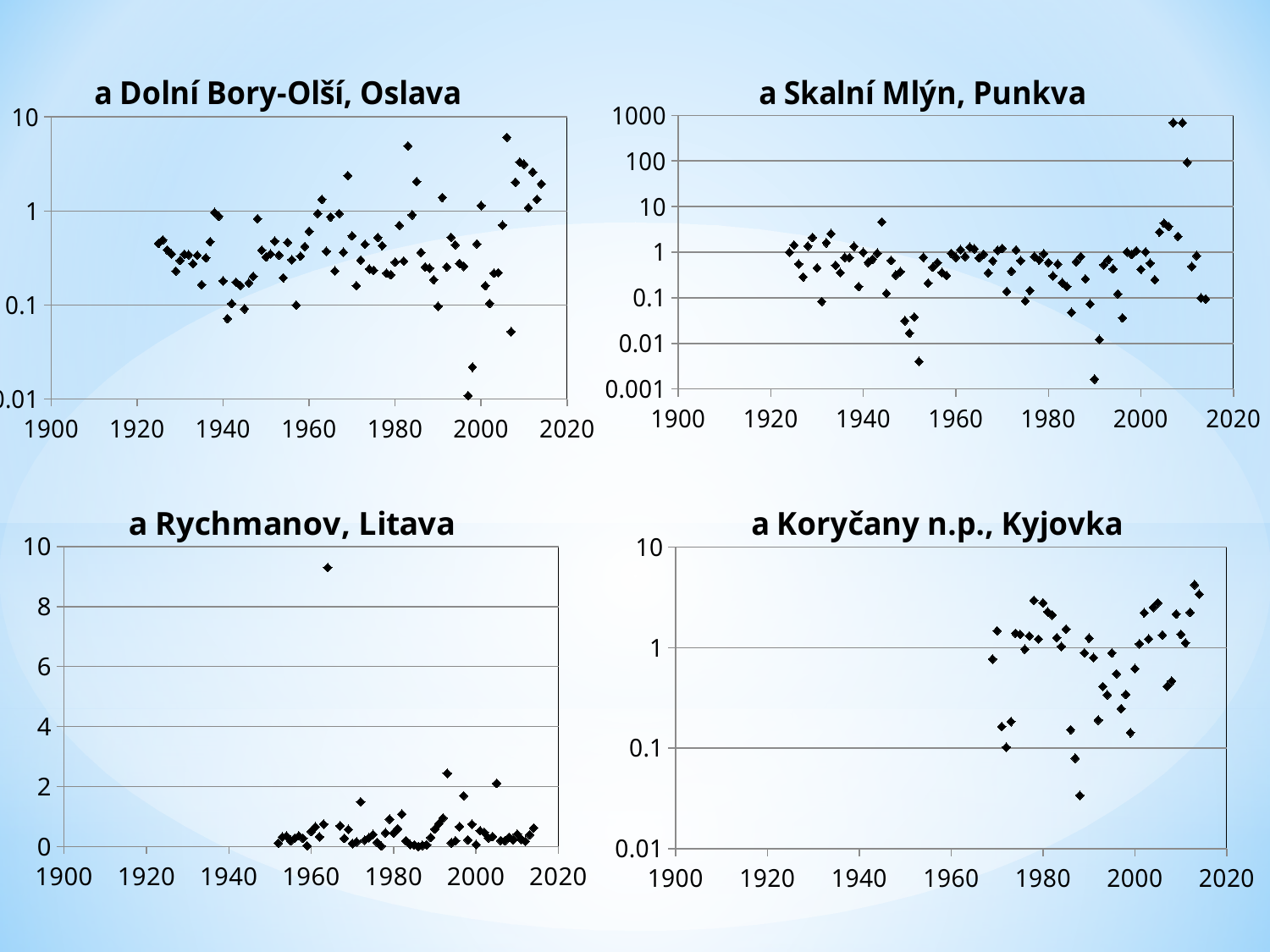
In the chart "a Skalní Mlýn, Punkva", are the two highest points (near 2008) greater or less than 100? greater In the chart "a Skalní Mlýn, Punkva", is the lowest plotted value (near 1990) greater or less than 0.01? less In the chart "a Koryčany n.p., Kyjovka", is the highest plotted value greater or less than 1? greater What kind of chart is "a Dolní Bory-Olší, Oslava"? scatter chart In the chart "a Rychmanov, Litava", which is larger: the outlier point between 1960 and 1980 or the highest point between 1980 and 2000? the outlier between 1960 and 1980 Which of the four charts uses a linear (non-logarithmic) y-axis? a Rychmanov, Litava How many charts are shown on the slide? 4 Which chart has a y-axis that goes up to 1000? a Skalní Mlýn, Punkva